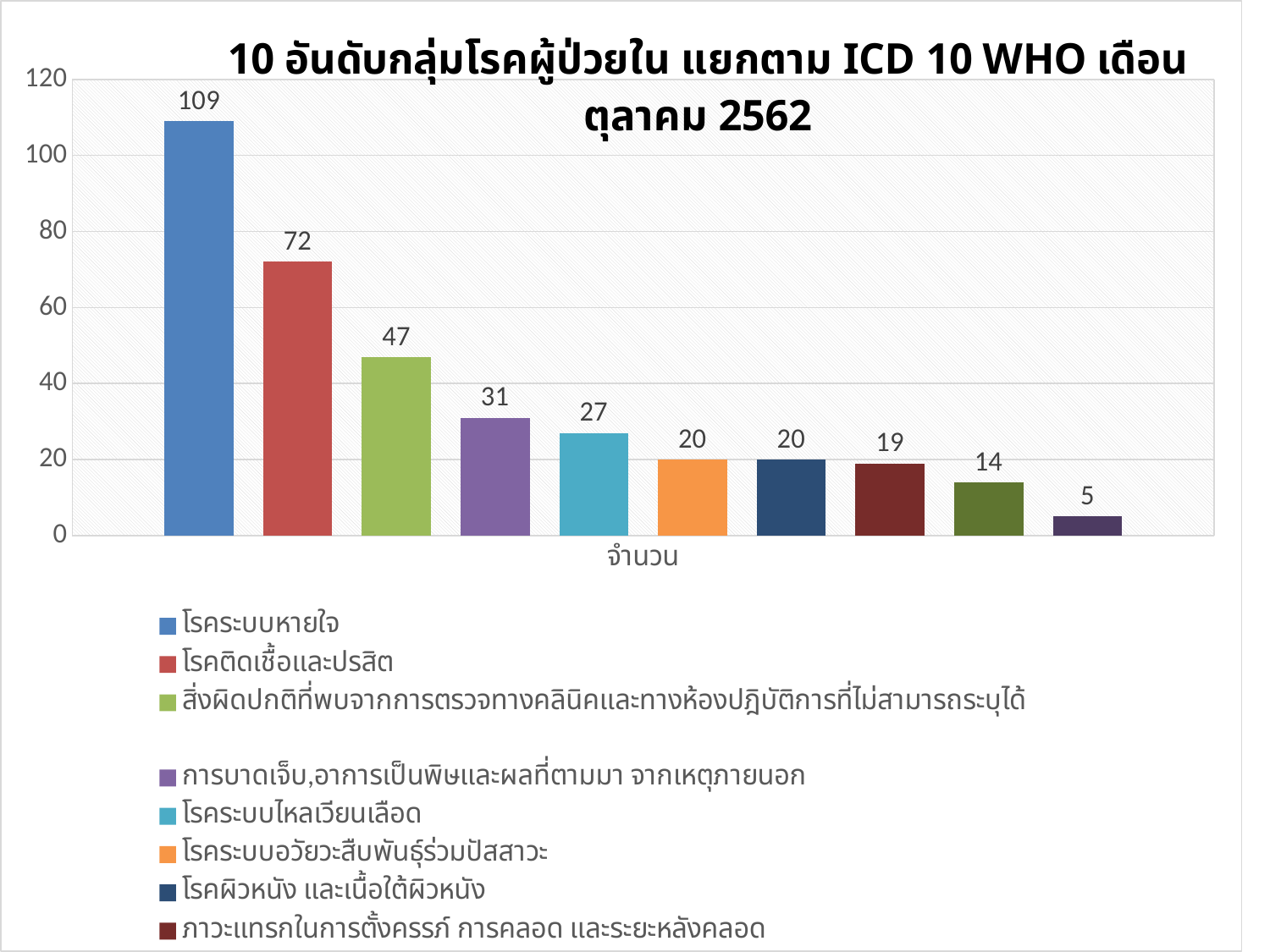
What is the lowest value shown on the chart? 5 What is the value for โรคระบบหายใจ? 109 Do the values rise or fall from left to right across the bars? Fall What is the value for ภาวะแทรกในการตั้งครรภ์ การคลอด และระยะหลังคลอด? 19 What is the difference between the values for โรคระบบหายใจ and โรคติดเชื้อและปรสิต? 37 What is the value for โรคติดเชื้อและปรสิต? 72 What type of chart is shown on the slide? Bar chart Which is larger, the value for โรคติดเชื้อและปรสิต or the value for โรคระบบไหลเวียนเลือด? โรคติดเชื้อและปรสิต How many bars are plotted on the chart? 10 Is the value for โรคระบบหายใจ greater or less than 100? greater Which disease group has the highest value? โรคระบบหายใจ What is the value for โรคระบบไหลเวียนเลือด? 27